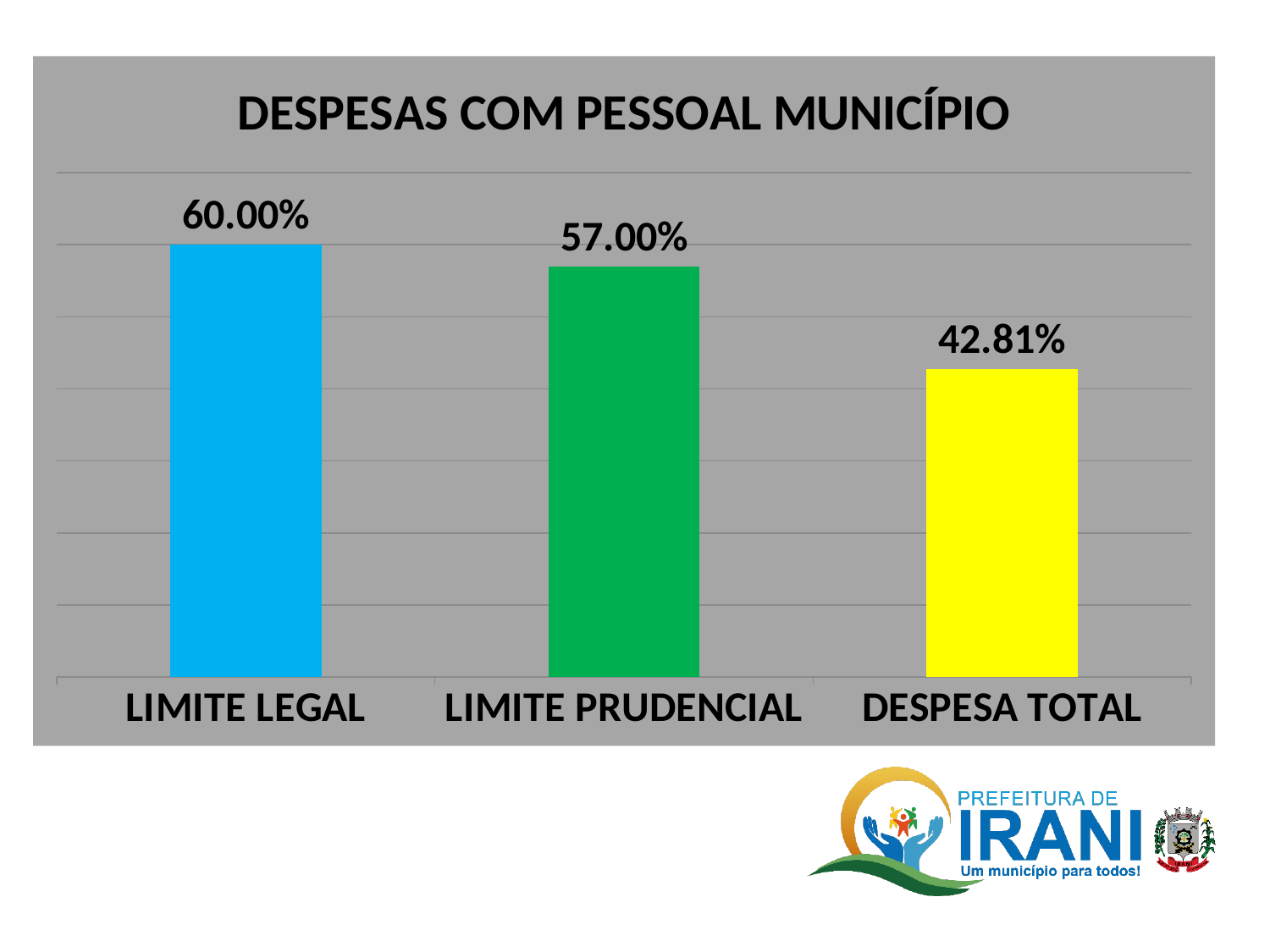
What is the value for LIMITE LEGAL? 60.00% Which category has the highest value? LIMITE LEGAL What is the value for DESPESA TOTAL? 42.81% What kind of chart is shown on the slide? bar chart Which category has the lowest value? DESPESA TOTAL What is the value for LIMITE PRUDENCIAL? 57.00% Which is larger, LIMITE PRUDENCIAL or DESPESA TOTAL? LIMITE PRUDENCIAL What is the difference between LIMITE LEGAL and LIMITE PRUDENCIAL? 3.00% What is the title of the chart? DESPESAS COM PESSOAL MUNICÍPIO What is the difference between LIMITE PRUDENCIAL and DESPESA TOTAL? 14.19% How many categories are shown in the chart? 3 Do the values rise or fall from left to right across the categories? fall